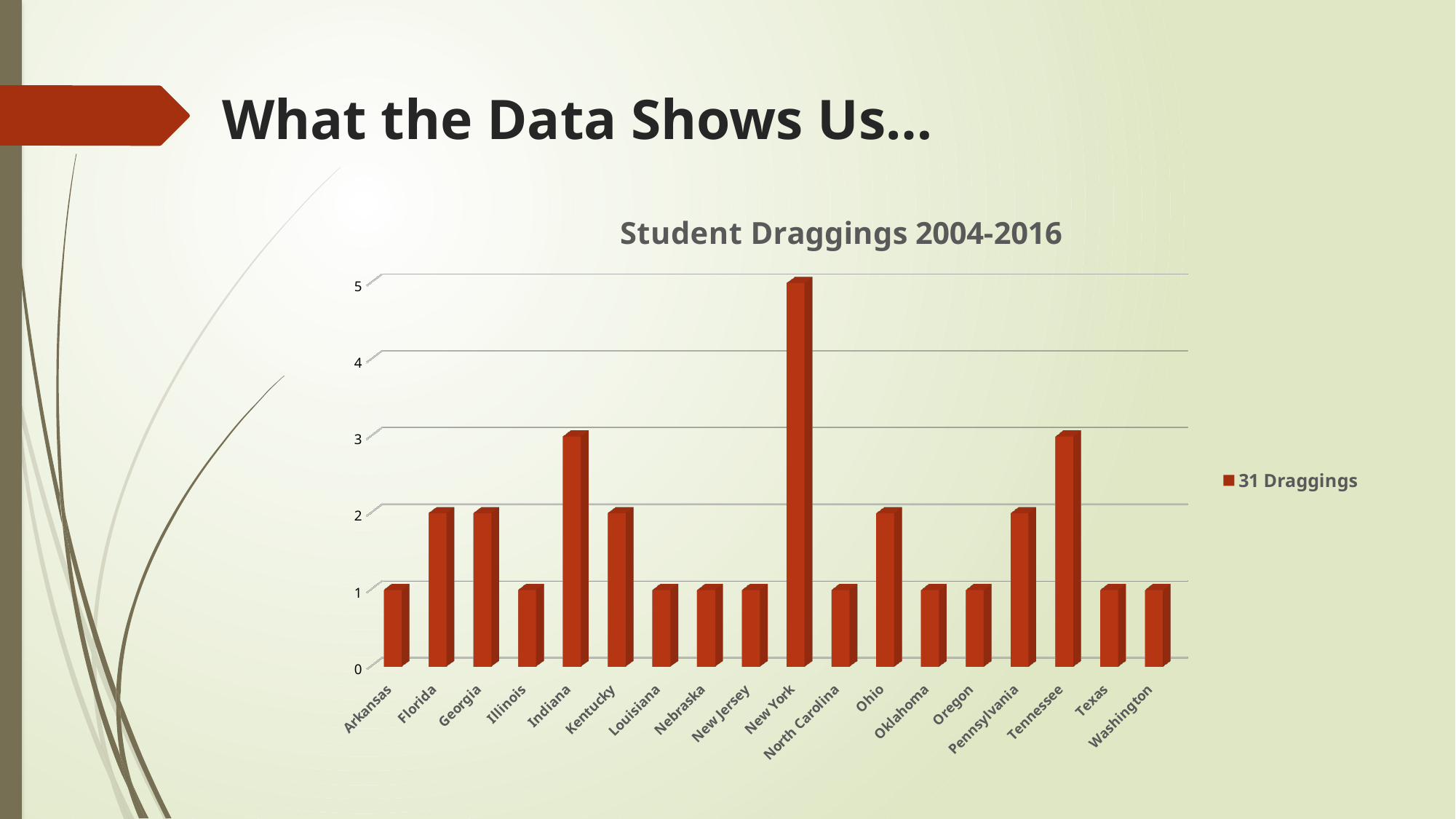
What kind of chart is shown on the slide? Bar chart What is the value for Florida? 2 What is the value for Indiana? 3 What is the legend entry for the series? 31 Draggings What is the difference between the values for New York and Tennessee? 2 Which state has the highest number of student draggings? New York How many series does the legend list? 1 Which is larger, the value for Ohio or the value for Oklahoma? Ohio What is the title of the chart? Student Draggings 2004-2016 What is the value for New York? 5 How many states are shown on the x axis? 18 What is the value for Texas? 1